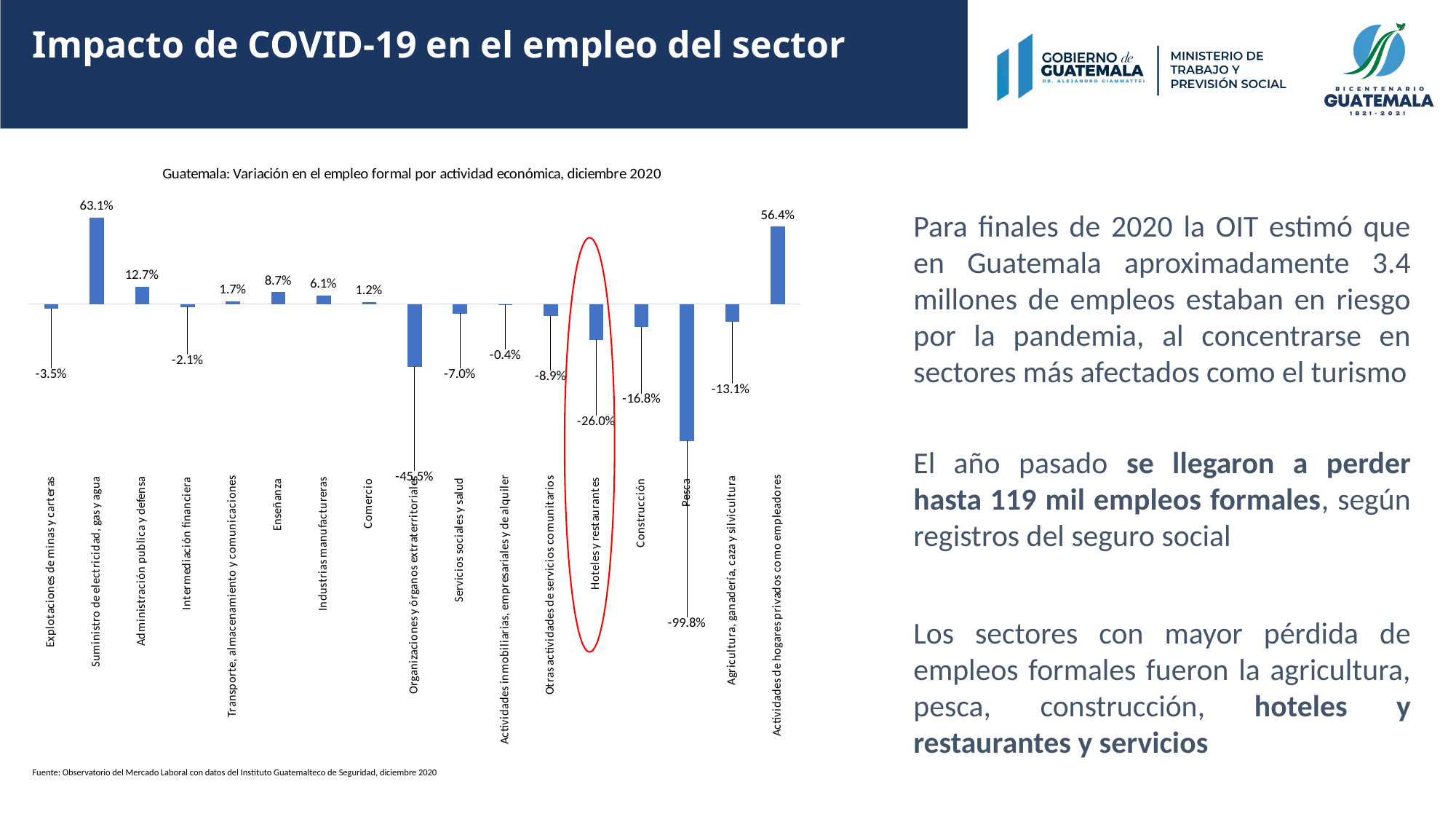
What is the value for Hoteles y restaurantes? -26.0% What is the difference between the values for Suministro de electricidad, gas y agua and Actividades de hogares privados como empleadores? 6.7 percentage points What is the value for Pesca? -99.8% How many categories are shown in the chart? 17 Which category has the lowest value? Pesca Which category has the highest value? Suministro de electricidad, gas y agua What is the value for Agricultura, ganadería, caza y silvicultura? -13.1% What is the value for Construcción? -16.8% What is the value for Enseñanza? 8.7% What is the title of the chart? Guatemala: Variación en el empleo formal por actividad económica, diciembre 2020 Which is larger, the value for Administración pública y defensa or the value for Industrias manufactureras? Administración pública y defensa What kind of chart is shown on the slide? Bar chart